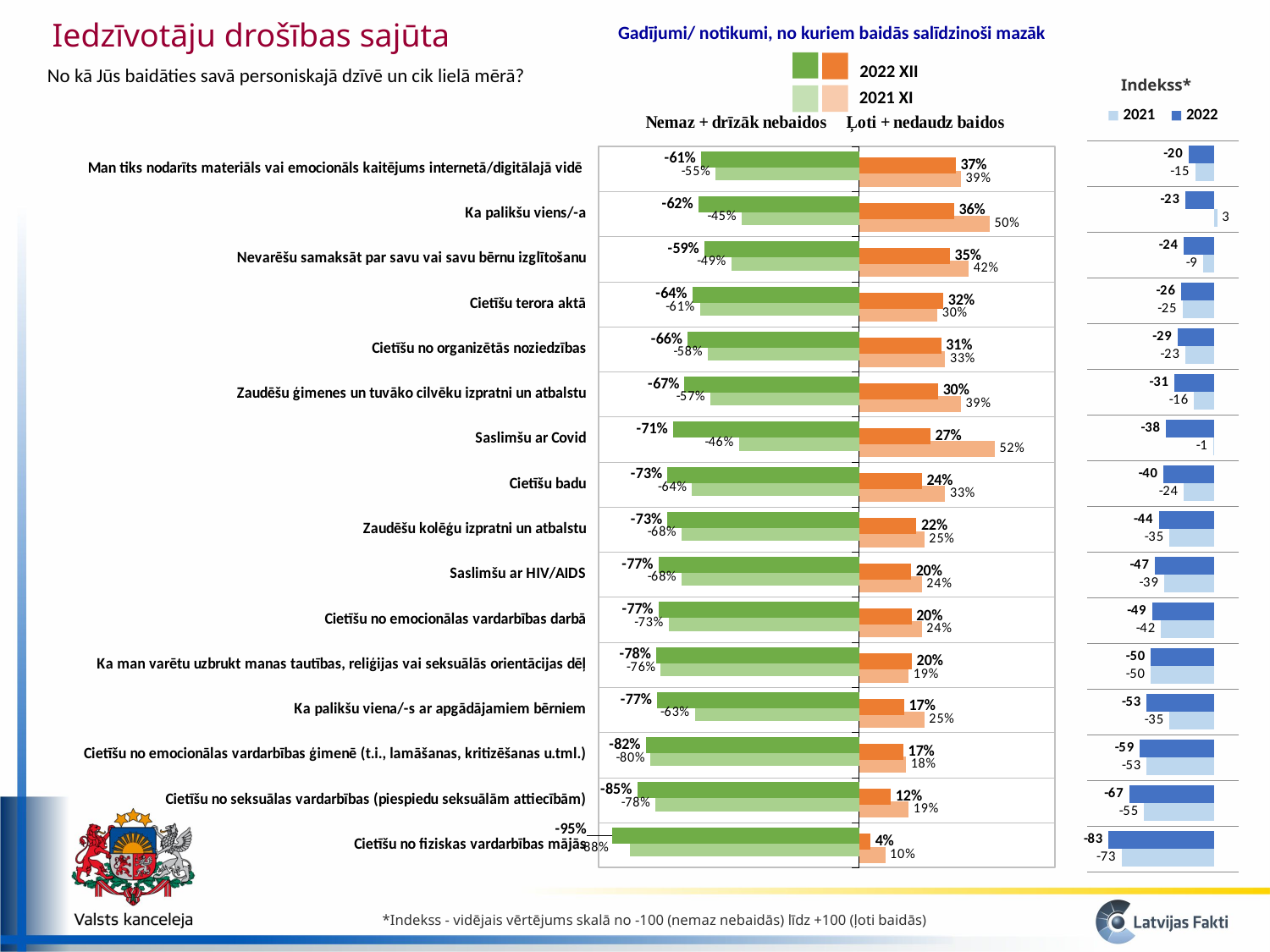
What kind of chart is the main chart? bar chart In the main chart, what is the difference between the 2021 XI and 2022 XII 'Ļoti + nedaudz baidos' shares for 'Saslimšu ar Covid'? 25 percentage points In the main chart, what is the 2022 XII share of 'Ļoti + nedaudz baidos' for 'Saslimšu ar Covid'? 27% In the main chart, what is the 2022 XII value of 'Nemaz + drīzāk nebaidos' for 'Cietīšu terora aktā'? -64% How many categories (fears) are listed in the main chart? 16 In the main chart, which category has the highest 2022 XII share of 'Ļoti + nedaudz baidos'? Man tiks nodarīts materiāls vai emocionāls kaitējums internetā/digitālajā vidē In the main chart, which category has the lowest 2022 XII share of 'Ļoti + nedaudz baidos'? Cietīšu no fiziskas vardarbības mājās In the main chart, what is the 2021 XI share of 'Ļoti + nedaudz baidos' for 'Ka palikšu viens/-a'? 50% In the Indekss* chart, what is the 2022 index value for 'Cietīšu no fiziskas vardarbības mājās'? -83 In the Indekss* chart, what is the 2021 index value for 'Ka palikšu viens/-a'? 3 How many series does the legend of the main chart list? 2 In the main chart, is the 2022 XII 'Ļoti + nedaudz baidos' share for 'Cietīšu badu' larger or smaller than the 2021 XI share? smaller